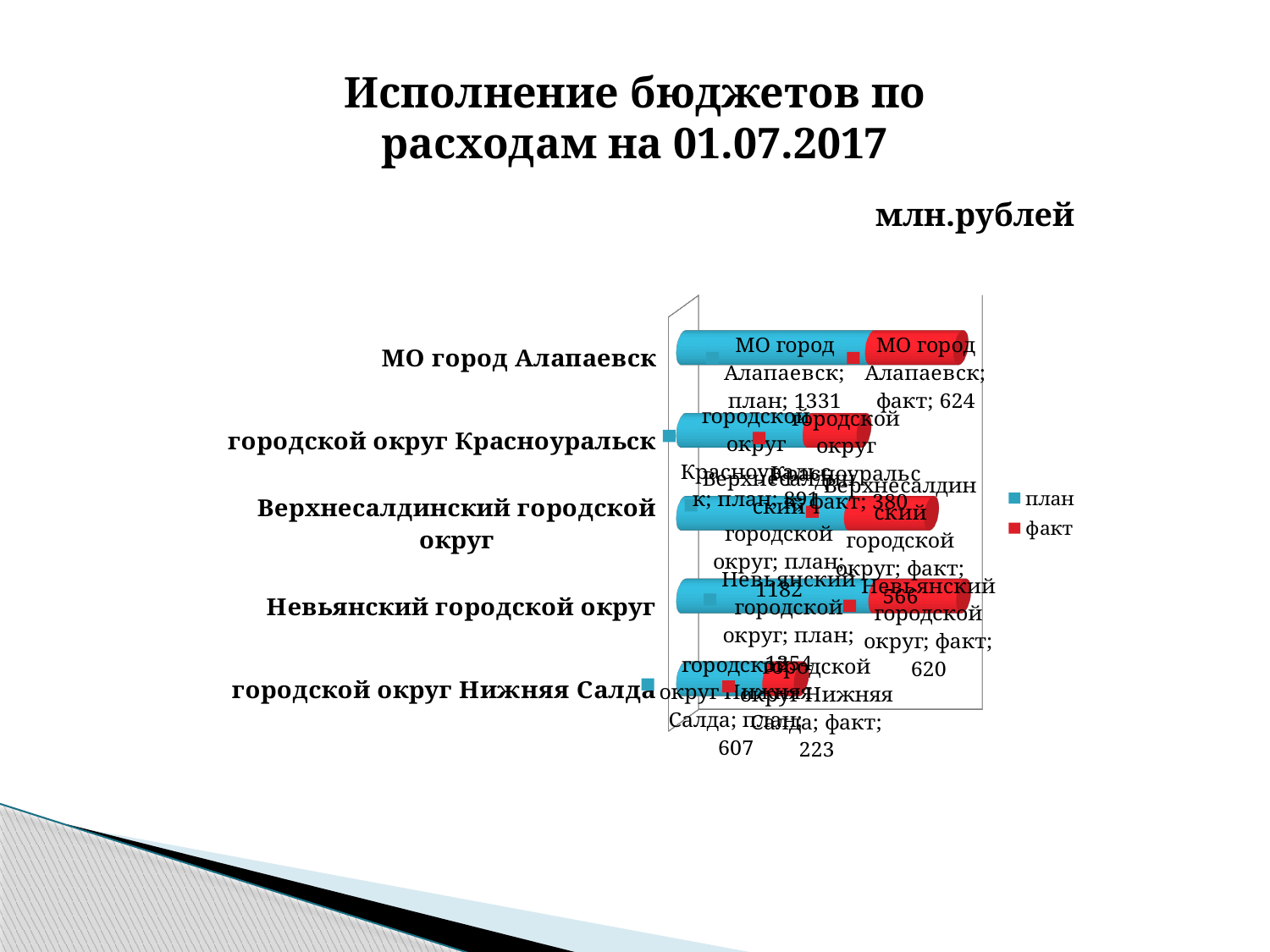
What is the total of план and факт for городской округ Нижняя Салда? 830 Which has the larger факт value: МО город Алапаевск or Верхнесалдинский городской округ? МО город Алапаевск What is the факт value for городской округ Красноуральск? 380 What is the difference between план and факт for МО город Алапаевск? 707 Which municipality has the lowest план value? городской округ Нижняя Салда What is the план value for МО город Алапаевск? 1331 What kind of chart is shown on the slide? bar chart What is the факт value for городской округ Нижняя Салда? 223 What is the план value for Верхнесалдинский городской округ? 1182 How many municipalities (categories) are shown in the chart? 5 How many series does the legend list? 2 What is the факт value for МО город Алапаевск? 624